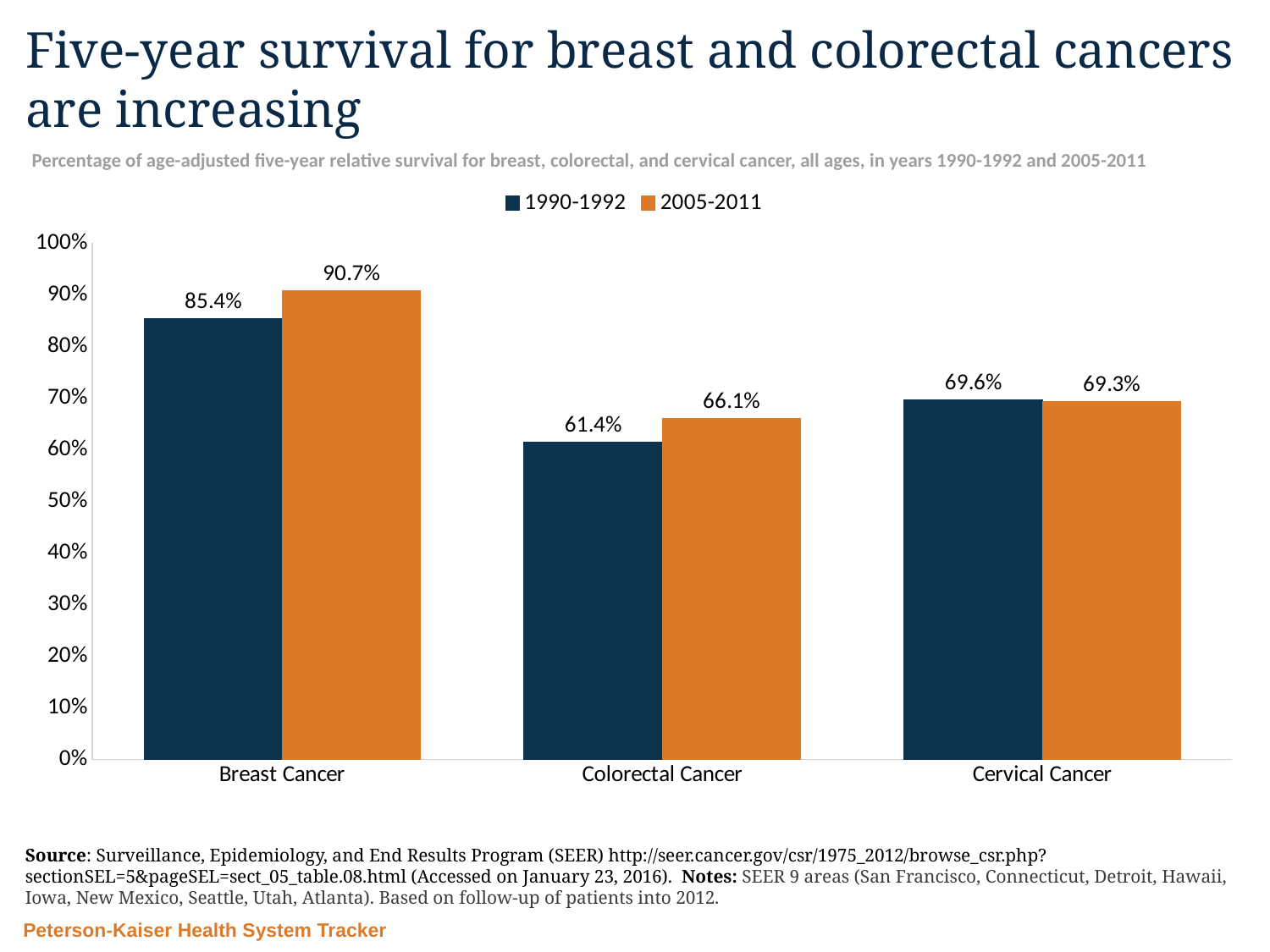
What is the five-year survival rate for Cervical Cancer in 1990-1992? 69.6% How many series does the legend list? 2 What is the five-year survival rate for Breast Cancer in 1990-1992? 85.4% Which cancer type has the highest five-year survival rate in 2005-2011? Breast Cancer Is the 2005-2011 survival rate for Colorectal Cancer higher or lower than its 1990-1992 rate? higher What kind of chart is shown on the slide? bar chart What is the difference between the 2005-2011 and 1990-1992 survival rates for Colorectal Cancer? 4.7 percentage points By how many percentage points did the five-year survival rate for Breast Cancer increase from 1990-1992 to 2005-2011? 5.3 percentage points What is the five-year survival rate for Colorectal Cancer in 2005-2011? 66.1% Which colour represents the 2005-2011 series in the legend? orange Which cancer type has the lowest five-year survival rate in 1990-1992? Colorectal Cancer How many cancer types are shown on the x axis? 3